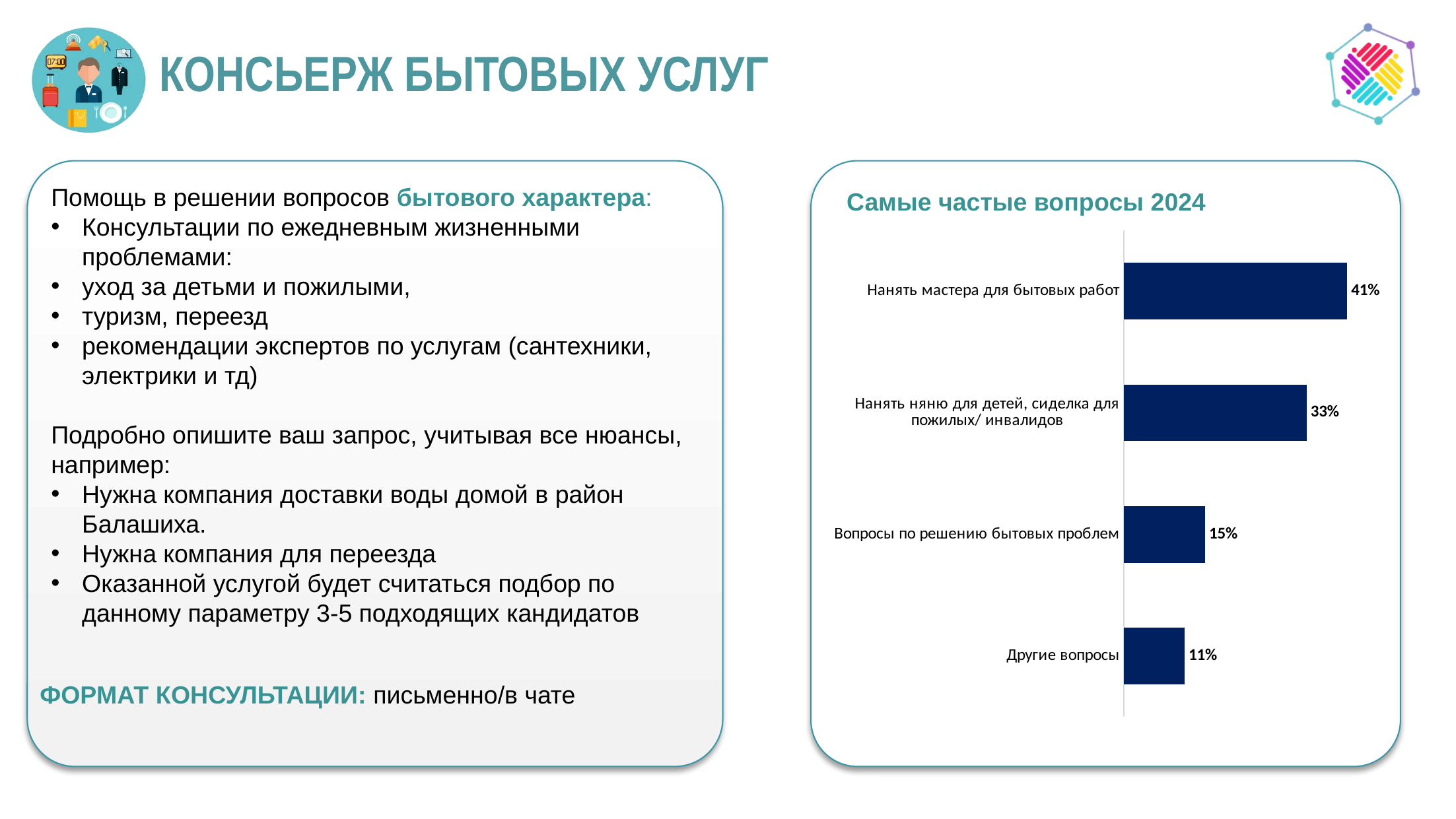
How many categories are shown in the chart? 4 What is the title of the chart? Самые частые вопросы 2024 What is the value for "Нанять няню для детей, сиделка для пожилых/ инвалидов"? 33% Which category has the highest value? Нанять мастера для бытовых работ What is the value for "Вопросы по решению бытовых проблем"? 15% What kind of chart is shown on the slide? Bar chart What is the value for "Другие вопросы"? 11% What is the value for "Нанять мастера для бытовых работ"? 41% What is the difference between the values for "Вопросы по решению бытовых проблем" and "Другие вопросы"? 4% What is the difference between the values for "Нанять мастера для бытовых работ" and "Нанять няню для детей, сиделка для пожилых/ инвалидов"? 8% Which category has the lowest value? Другие вопросы Which is larger: the value for "Нанять няню для детей, сиделка для пожилых/ инвалидов" or for "Вопросы по решению бытовых проблем"? Нанять няню для детей, сиделка для пожилых/ инвалидов